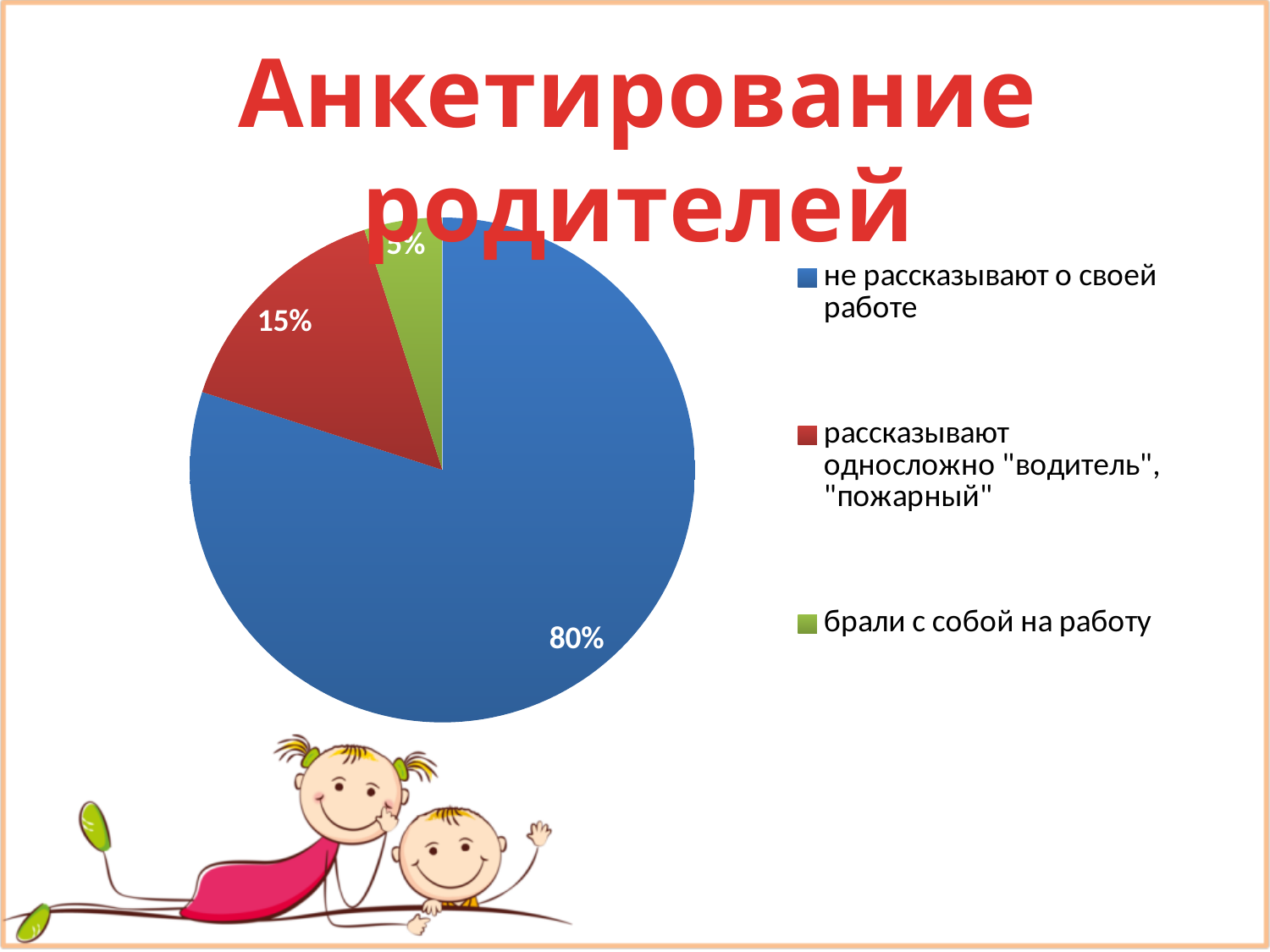
By how many percentage points does "не рассказывают о своей работе" exceed "рассказывают односложно "водитель", "пожарный""? 65 percentage points Which is larger: the slice for "рассказывают односложно "водитель", "пожарный"" or the slice for "брали с собой на работу"? рассказывают односложно "водитель", "пожарный" What is the title of the slide containing the pie chart? Анкетирование родителей What percentage of parents "не рассказывают о своей работе"? 80% What colour is the slice for "брали с собой на работу"? green What kind of chart is shown on the slide? pie chart How many slices does the pie chart have? 3 What share of the pie does "не рассказывают о своей работе" take? 80% What percentage of parents "рассказывают односложно "водитель", "пожарный""? 15% How many entries does the legend list? 3 Which category has the smallest slice of the pie? брали с собой на работу Which category has the largest slice of the pie? не рассказывают о своей работе